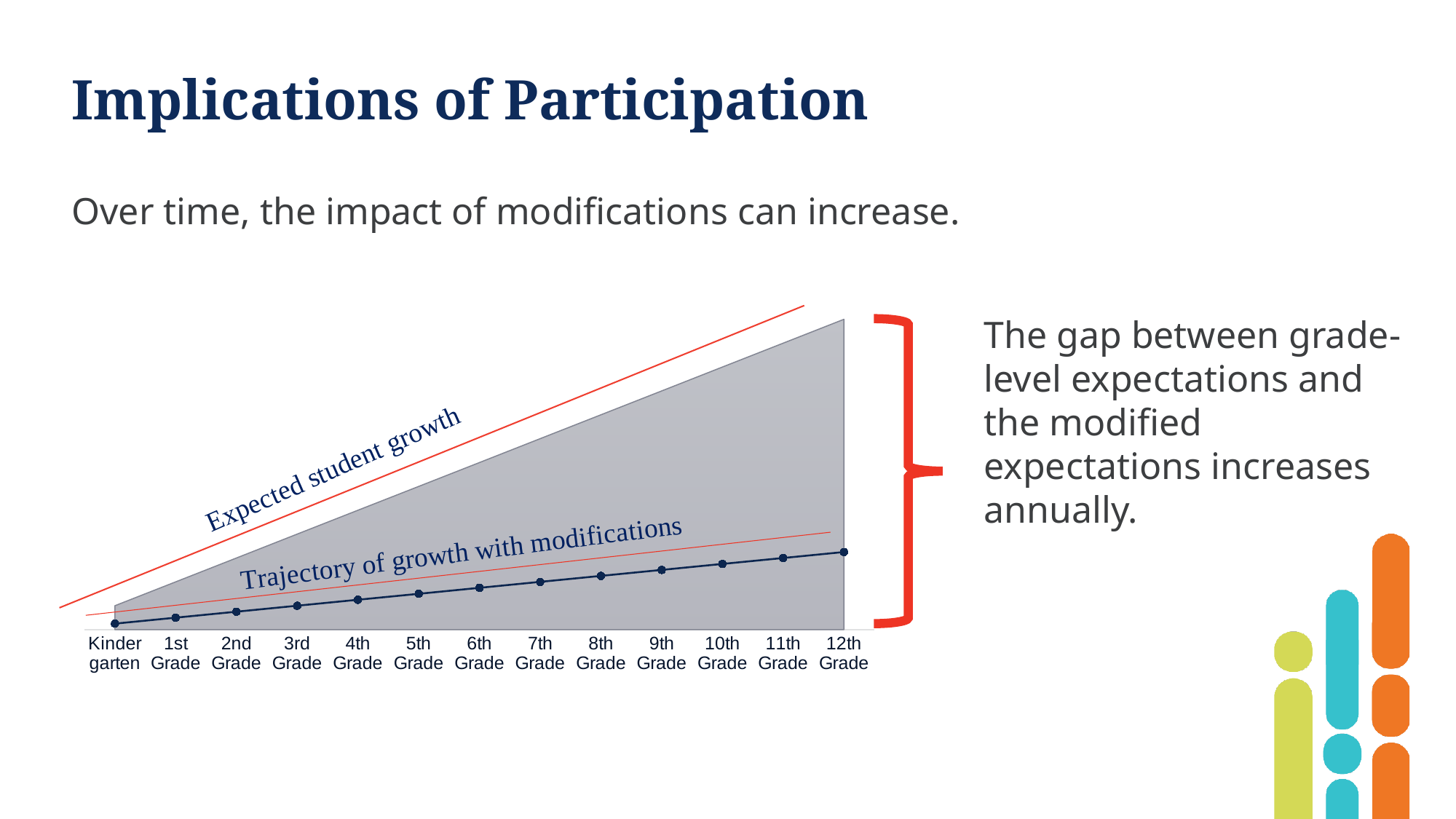
What is the last category on the x axis of the chart? 12th Grade How many grade levels are shown along the x axis of the chart? 13 At 12th Grade, which is higher on the chart: 'Expected student growth' or 'Trajectory of growth with modifications'? Expected student growth Does the 'Trajectory of growth with modifications' line rise or fall from Kindergarten to 12th Grade? rise Does the gap between the two lines on the chart widen or narrow as grade level increases? widen Does the 'Expected student growth' line rise or fall along the x axis? rise What is the first category on the x axis of the chart? Kindergarten Which of the two lines on the chart has the steeper slope? Expected student growth What kind of chart is shown on the slide? combination area and line chart How many plotted data points are on the 'Trajectory of growth with modifications' line? 13